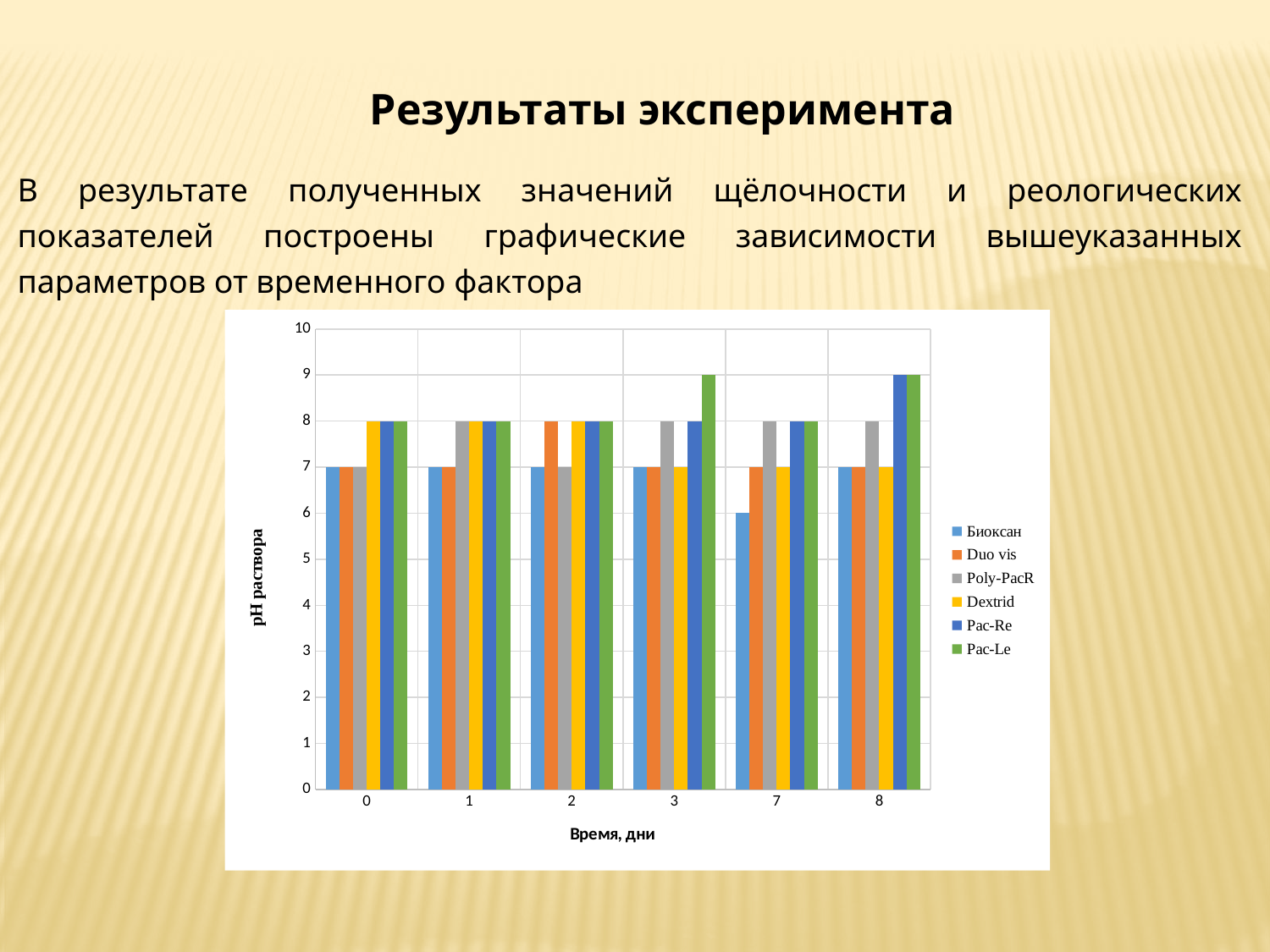
What kind of chart is shown on the slide? bar chart What is the pH value for Dextrid at day 0? 8 What is the pH value for Биоксан at day 7? 6 At day 2, which is larger: the pH for Duo vis or for Poly-PacR? Duo vis What is the label of the y axis? pH раствора Which series has the highest pH value at day 3? Pac-Le What is the pH value for Pac-Re at day 8? 9 What is the difference between the pH of Pac-Re and Биоксан at day 8? 2 How many series does the legend list? 6 How many time categories are shown on the x axis? 6 What is the pH value for Pac-Le at day 3? 9 Which series has the lowest pH value at day 7? Биоксан